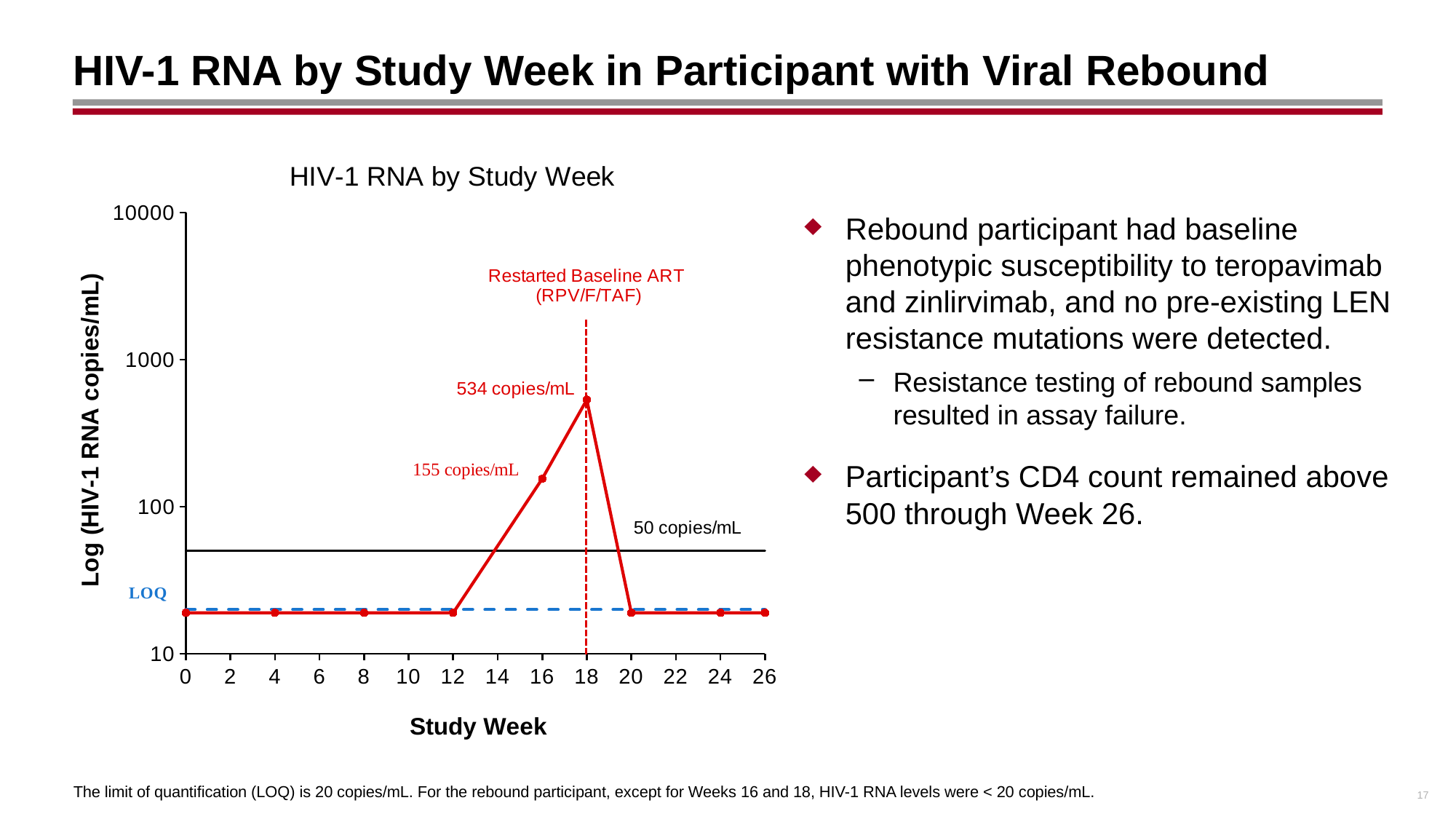
What is the HIV-1 RNA value at Study Week 16? 155 copies/mL Does the HIV-1 RNA level rise or fall between Week 12 and Week 18? Rise What value does the solid black horizontal line on the chart represent? 50 copies/mL Which has the higher HIV-1 RNA value, Week 16 or Week 18? Week 18 How many data points are plotted on the HIV-1 RNA line? 9 What is the difference between the HIV-1 RNA values at Week 18 and Week 16? 379 copies/mL Is the HIV-1 RNA value at Week 16 greater or less than 100 copies/mL? greater What event does the vertical dashed red line at Week 18 mark? Restarted Baseline ART (RPV/F/TAF) Is the HIV-1 RNA value at Week 20 greater or less than 100 copies/mL? less What is the HIV-1 RNA value at Study Week 18? 534 copies/mL At which study week is the HIV-1 RNA level highest? Week 18 What kind of chart is shown on the slide? Line chart